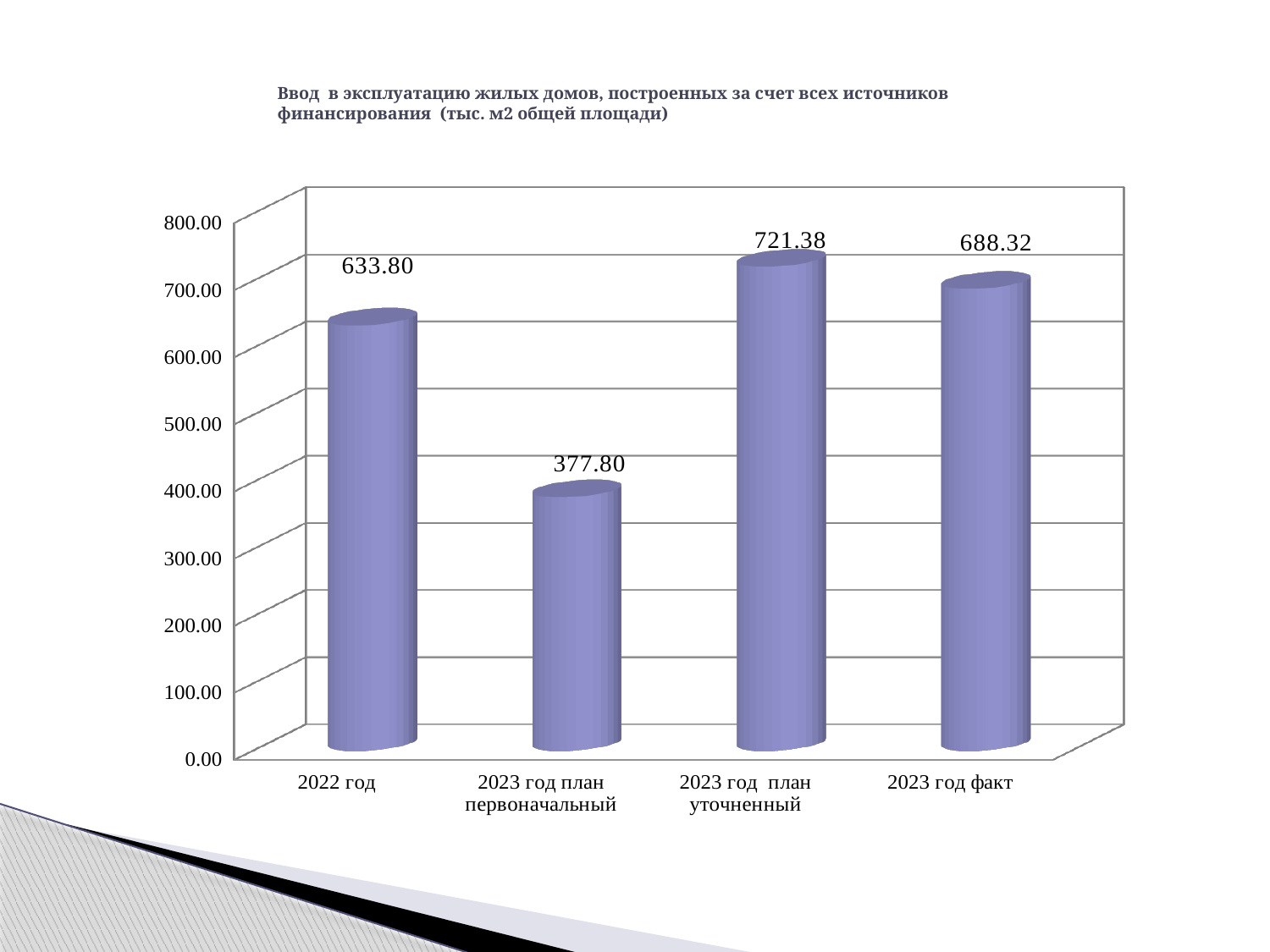
What is the value for 2023 год факт? 688.32 Which category has the highest value? 2023 год план уточненный Which is larger, the value for 2022 год or the value for 2023 год факт? 2023 год факт What is the value for 2023 год план уточненный? 721.38 How many categories are shown on the x axis? 4 Which category has the lowest value? 2023 год план первоначальный What is the value for 2023 год план первоначальный? 377.80 What is the value for 2022 год? 633.80 Is the value for 2023 год план первоначальный greater or less than 400.00? less What is the difference between the values for 2023 год план уточненный and 2023 год факт? 33.06 What is the difference between the values for 2022 год and 2023 год план первоначальный? 256.00 What kind of chart is shown on the slide? bar chart